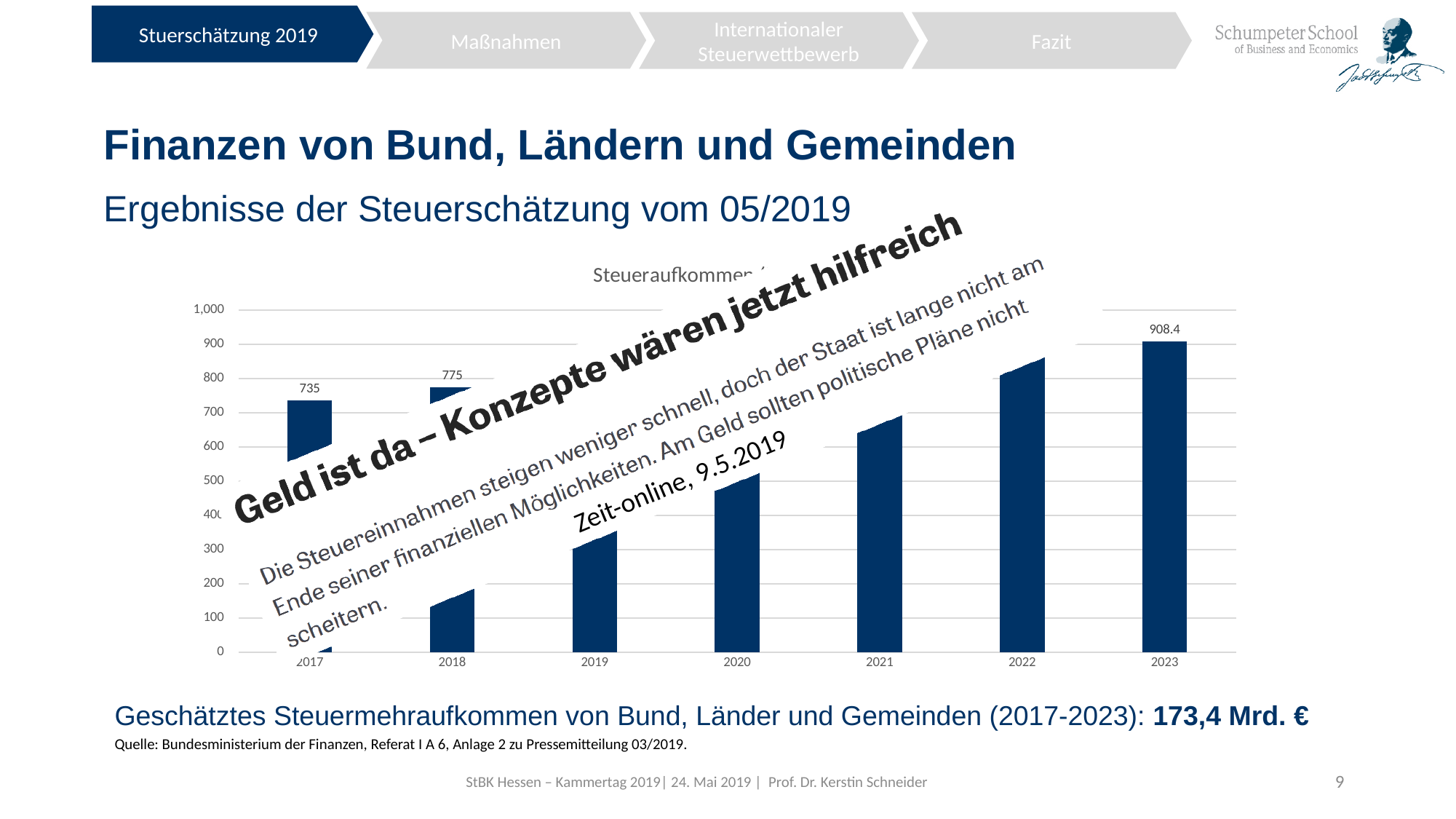
How many years are shown on the x axis? 7 What is the value shown for 2017? 735 Which year has the highest bar? 2023 What is the difference between the values for 2018 and 2017? 40 Is the value for 2023 greater or less than 900? greater What is the value shown for 2023? 908.4 What is the value shown for 2018? 775 What kind of chart is shown on the slide? bar chart Which year has the lowest bar? 2017 Which is larger, the value for 2017 or the value for 2018? 2018 What is the difference between the values for 2023 and 2017? 173.4 Do the values rise or fall from 2017 to 2023? rise